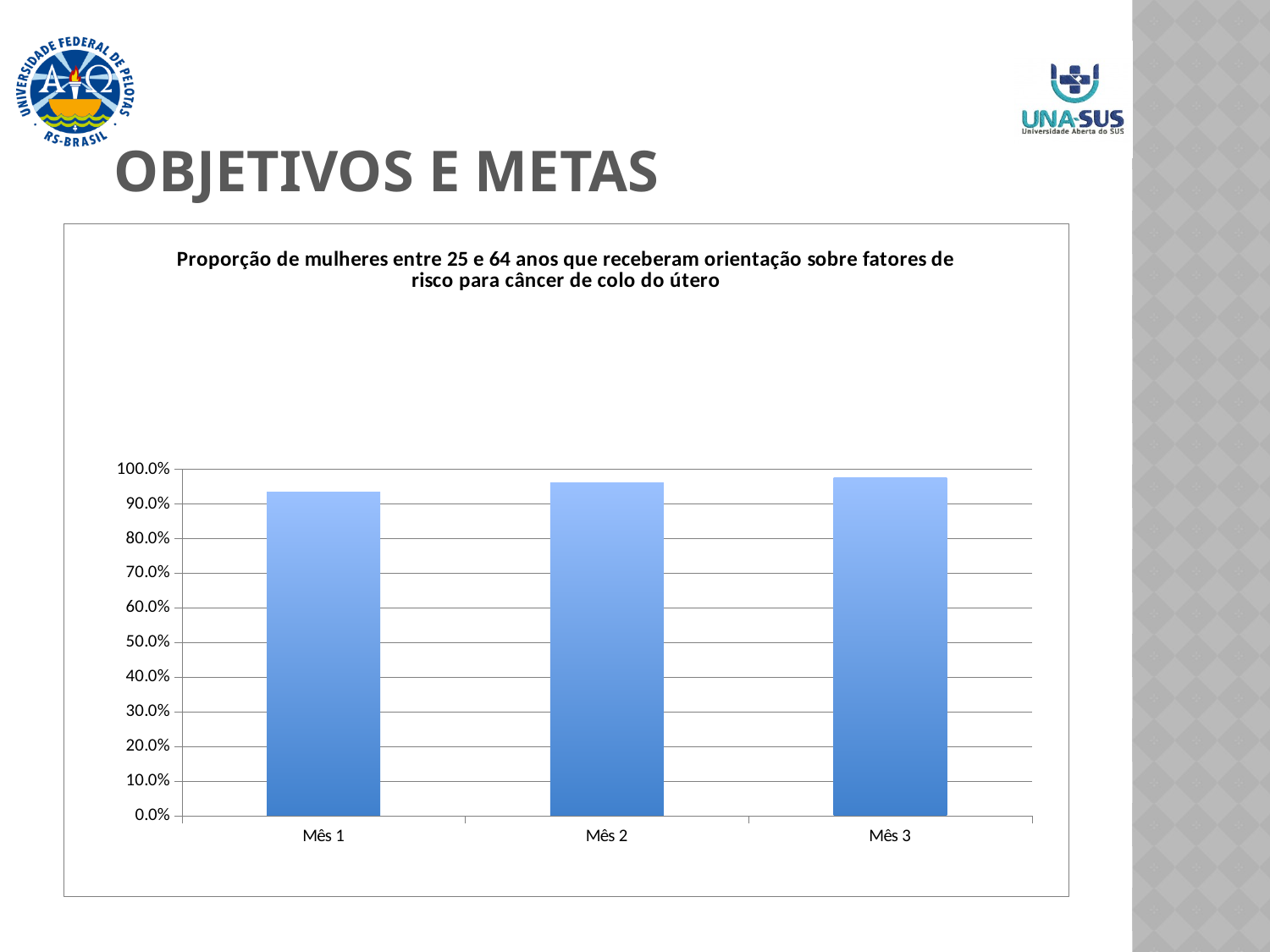
Is the value for Mês 2 greater or less than 90.0%? greater What is the highest value shown on the vertical axis of the chart? 100.0% Is the value for Mês 3 greater or less than 100.0%? less Which is larger, the value for Mês 1 or the value for Mês 3? Mês 3 What is the title of the chart? Proporção de mulheres entre 25 e 64 anos que receberam orientação sobre fatores de risco para câncer de colo do útero Which month has the lowest proportion on the chart? Mês 1 What kind of chart is shown on the slide? bar chart Is the value for Mês 1 greater or less than 80.0%? greater Do the values rise or fall from Mês 1 to Mês 3? rise How many categories (months) are plotted on the chart? 3 Which is larger, the value for Mês 1 or the value for Mês 2? Mês 2